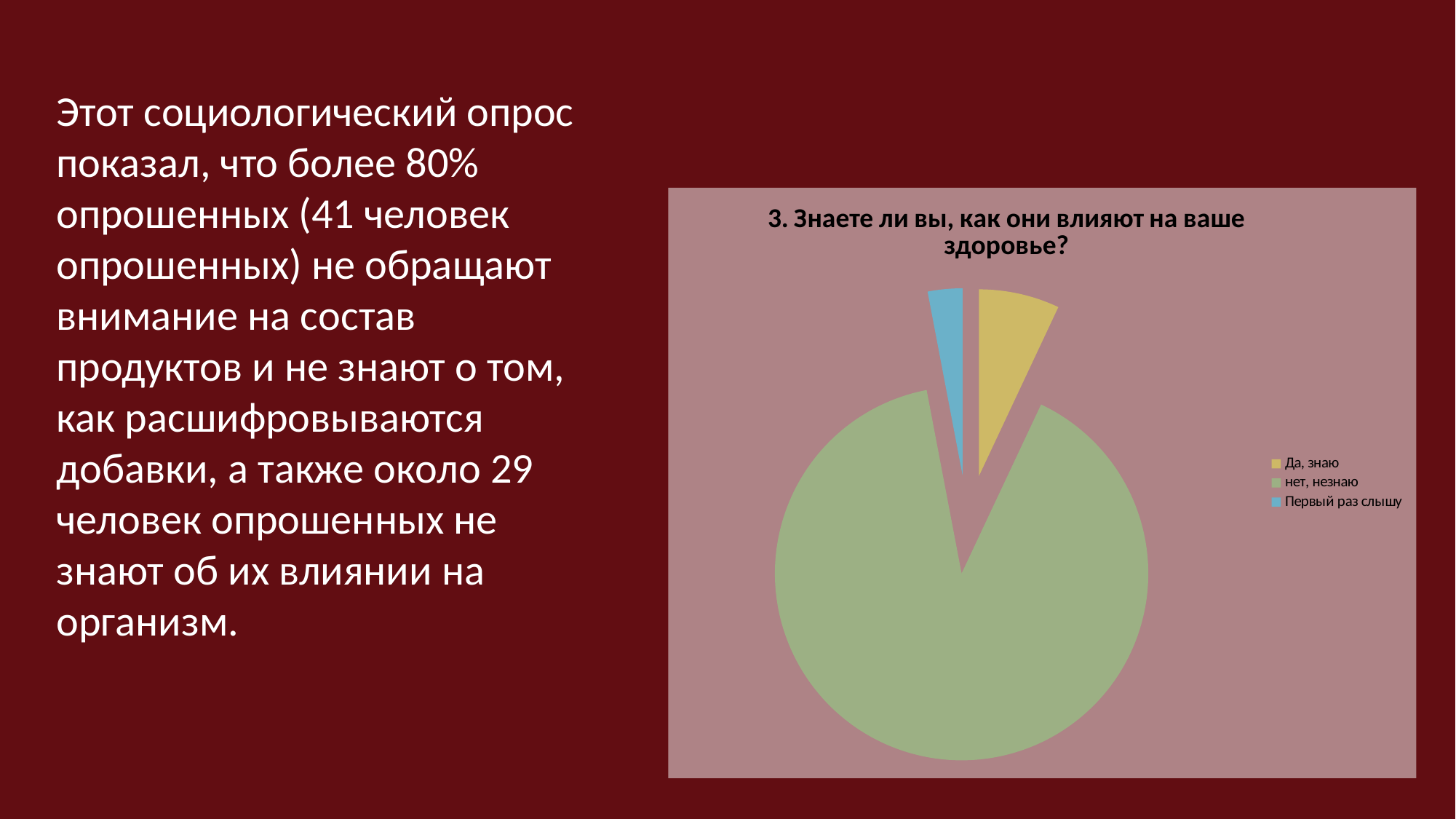
What is the title of the chart? 3. Знаете ли вы, как они влияют на ваше здоровье? Which slice is larger: "нет, незнаю" or "Да, знаю"? нет, незнаю How many entries does the chart legend list? 3 Which category has the largest slice of the pie? нет, незнаю Which slice is larger: "Да, знаю" or "Первый раз слышу"? Да, знаю How many slices does the pie chart have? 3 What colour is the slice for "нет, незнаю"? green What kind of chart is shown on the slide? pie chart Which category has the smallest slice of the pie? Первый раз слышу